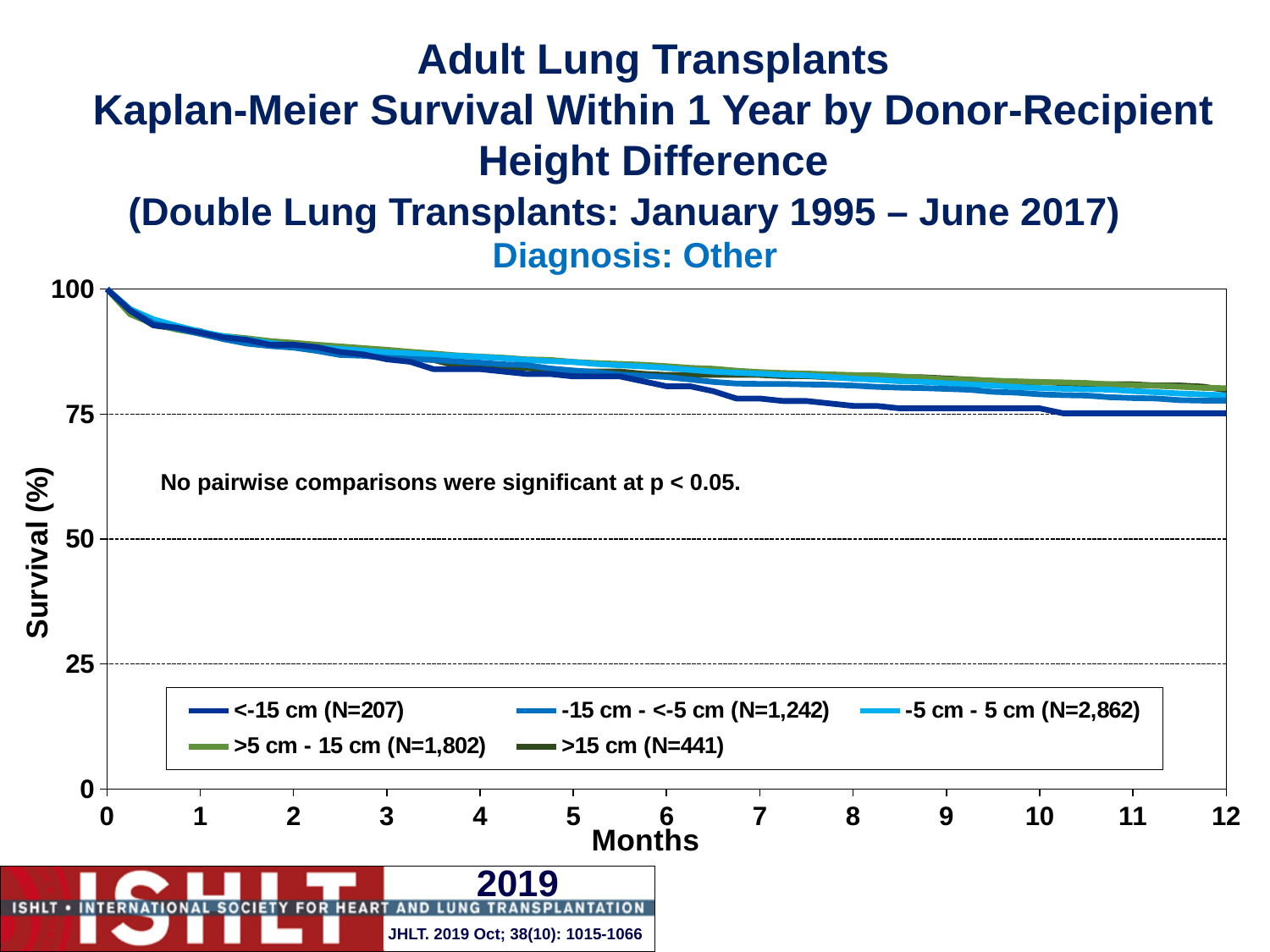
Which group has the lowest survival at 12 months? <-15 cm What kind of chart is shown on the slide? line chart What is the N for the <-15 cm group shown in the legend? 207 What is the label of the y axis? Survival (%) At 6 months, is survival for the <-15 cm group greater or less than 75? greater At 12 months, is survival for the -5 cm - 5 cm group greater or less than 75? greater What is the N for the -5 cm - 5 cm group shown in the legend? 2,862 Which group has the largest N in the legend? -5 cm - 5 cm (N=2,862) Do the survival curves rise or fall as months increase along the x axis? fall Which group has the smallest N in the legend? <-15 cm (N=207) How many series does the legend list? 5 What is the N for the >15 cm group shown in the legend? 441